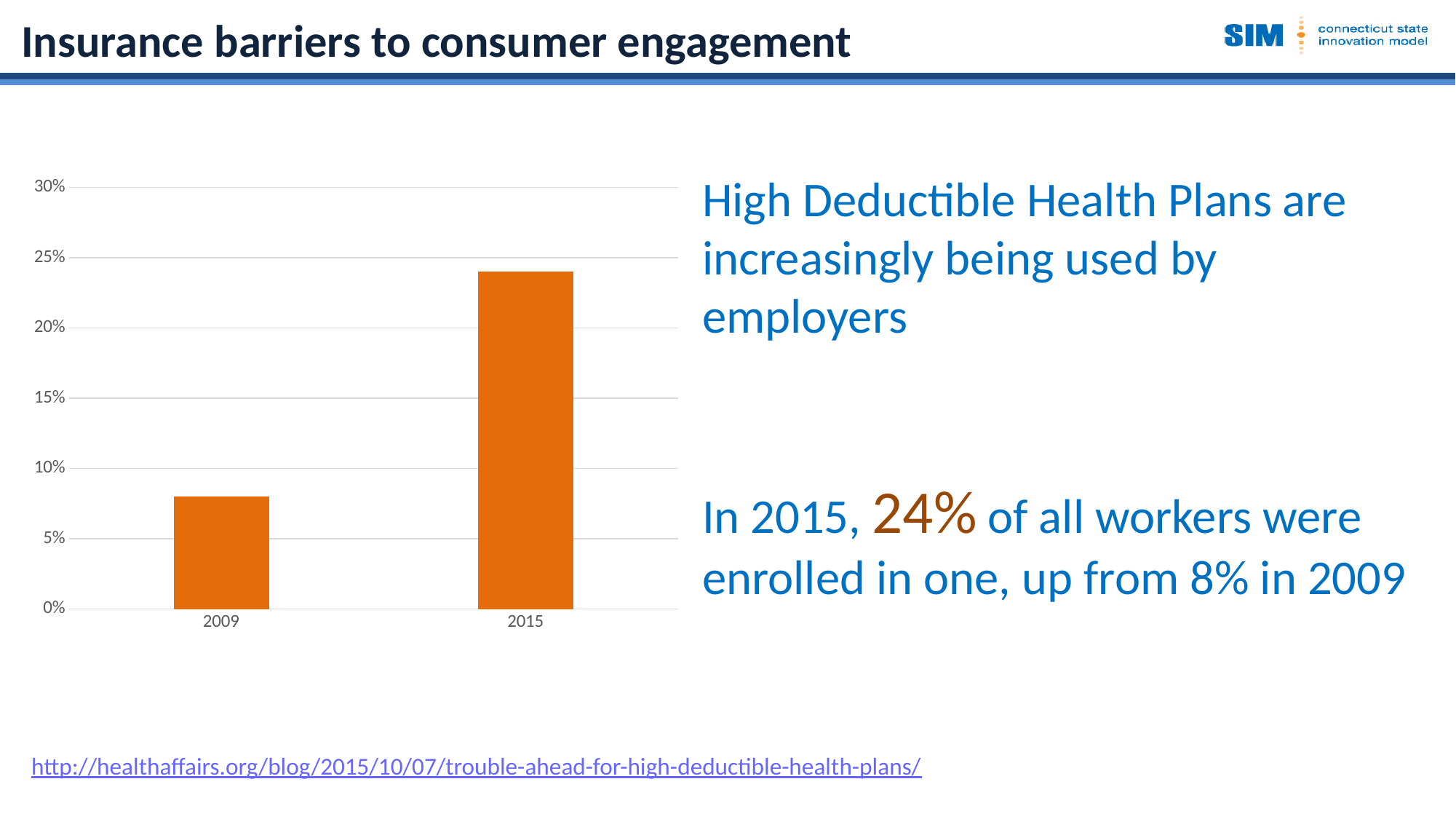
Which year has the higher bar in the chart? 2015 What percentage of workers were enrolled in a High Deductible Health Plan in 2009, according to the slide? 8% What is the highest value shown on the chart's y axis? 30% By how many percentage points did enrollment rise from 2009 to 2015, based on the values stated on the slide? 16 percentage points What type of chart is shown on the slide? bar chart Do the values rise or fall from 2009 to 2015? rise How many categories (years) are shown on the x axis of the chart? 2 Is the value for 2015 greater or less than 20%? greater What percentage of workers were enrolled in a High Deductible Health Plan in 2015, according to the slide? 24% Which year has the lower bar in the chart? 2009 Is the bar for 2015 larger or smaller than the bar for 2009? larger Is the value for 2009 greater or less than 10%? less